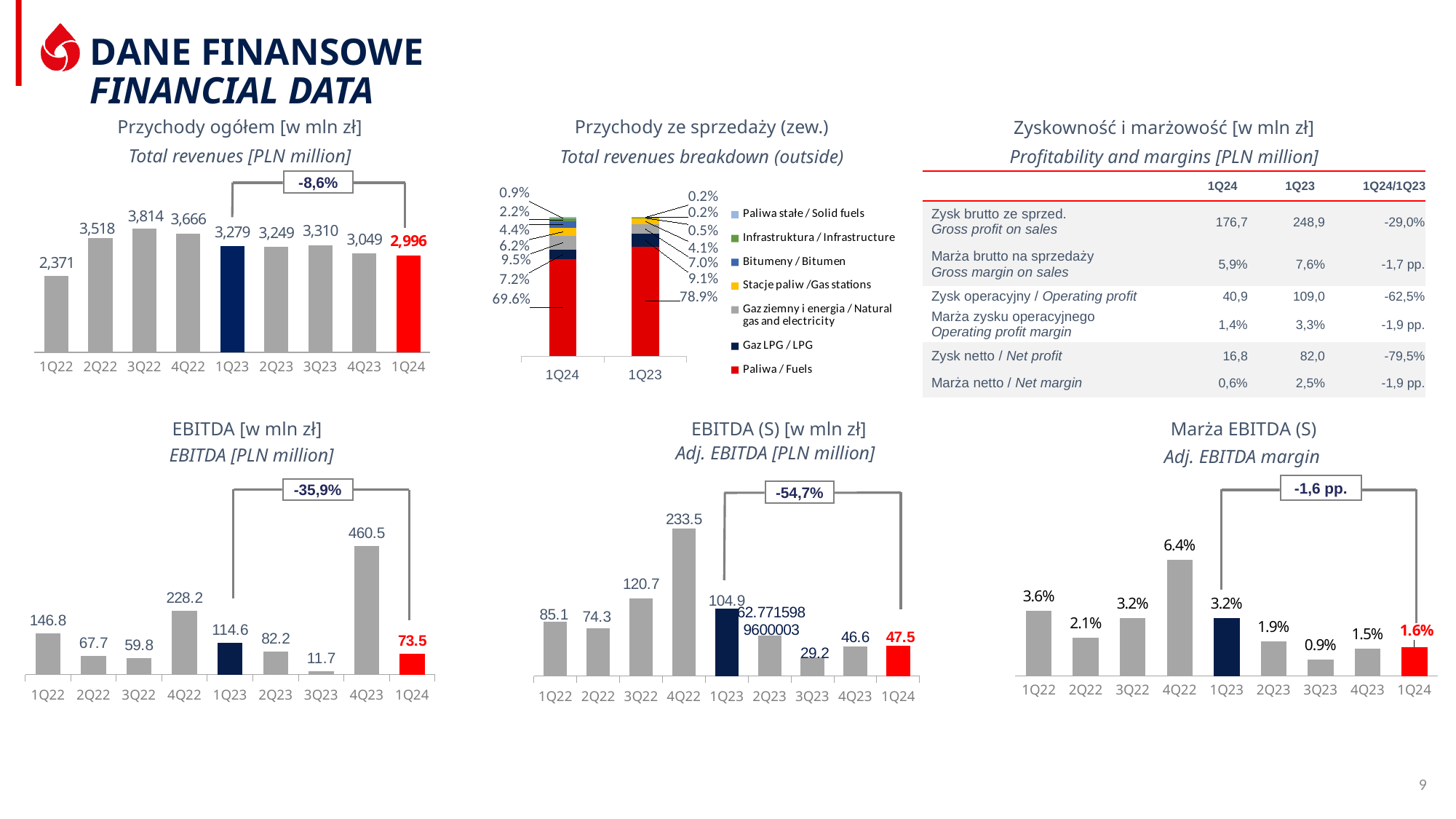
In the Total revenues chart, which quarter has the lowest value? 1Q22 In the Adj. EBITDA chart, which is larger, 1Q23 or 1Q24? 1Q23 What type of chart is the Adj. EBITDA margin chart? Bar chart In the Adj. EBITDA chart, what is the value for 4Q22? 233.5 In the EBITDA chart, how many quarters are shown? 9 In the Total revenues chart, what is the value for 3Q22? 3,814 In the Total revenues breakdown chart, how many series does the legend list? 7 In the Adj. EBITDA margin chart, which quarter has the lowest value? 3Q23 In the Total revenues breakdown chart, what share do Fuels have in 1Q24? 69.6% In the EBITDA chart, what is the value for 3Q23? 11.7 In the EBITDA chart, which quarter has the highest value? 4Q23 In the Total revenues chart, what is the difference between 1Q23 and 1Q24? 283